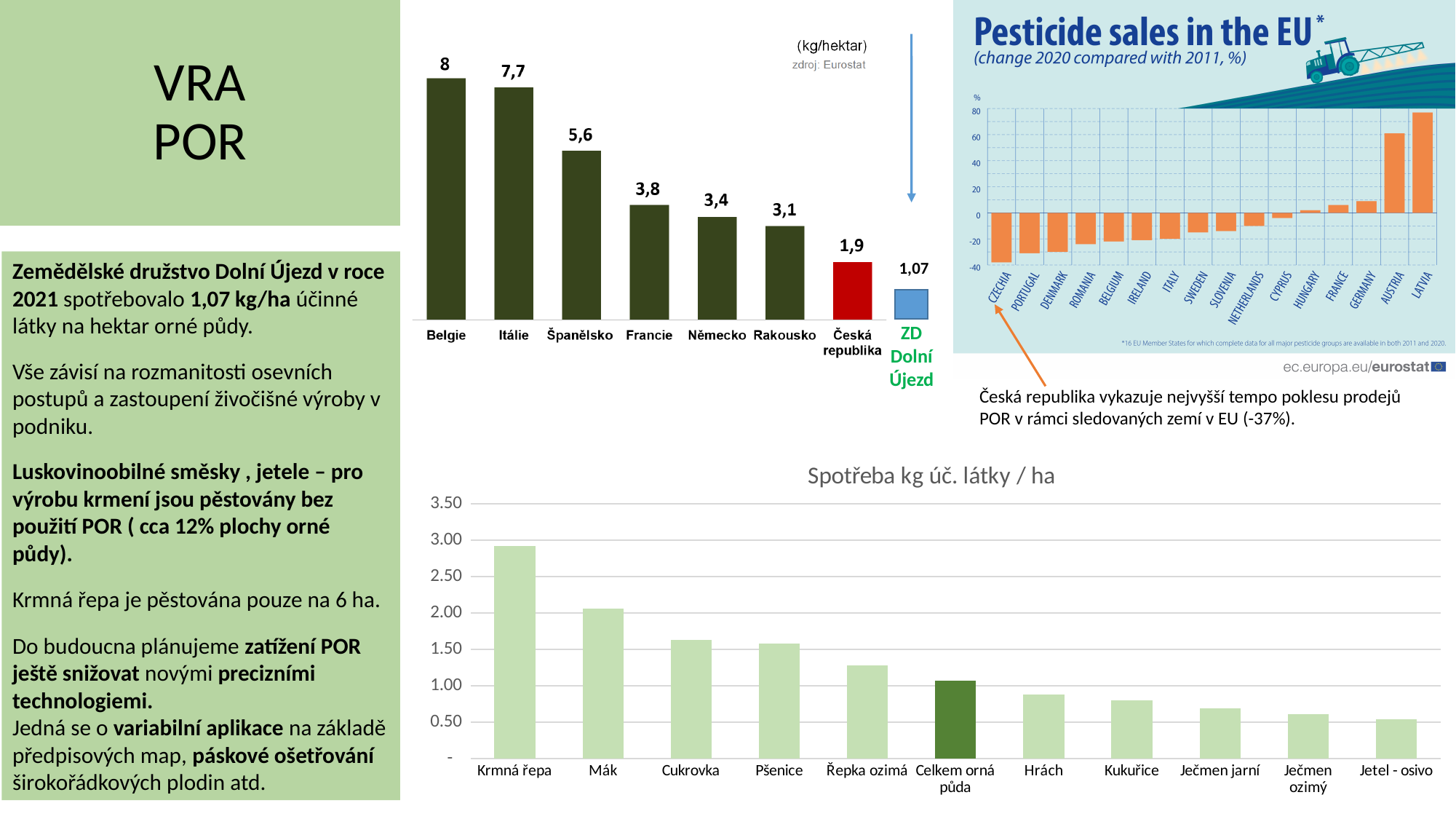
In the 'Pesticide sales in the EU' chart, which country has the highest value? Latvia In the top-middle bar chart (kg/hektar), what is the value for Česká republika? 1,9 In the top-middle bar chart (kg/hektar), which category has the highest value? Belgie In the top-middle bar chart (kg/hektar), what is the difference between the values for Itálie and Španělsko? 2,1 In the top-middle bar chart (kg/hektar), what is the value for Belgie? 8 In the 'Pesticide sales in the EU' chart, which country has the lowest value? Czechia In the 'Spotřeba kg úč. látky / ha' chart, is the value for Hrách greater or less than 1.00? less In the top-middle bar chart (kg/hektar), which is larger, the value for Francie or the value for Rakousko? Francie In the top-middle bar chart (kg/hektar), what is the value for ZD Dolní Újezd? 1,07 How many categories are shown in the top-middle bar chart (kg/hektar)? 8 In the 'Pesticide sales in the EU' chart, is the value for Austria greater or less than 40? greater In the 'Spotřeba kg úč. látky / ha' chart, which category has the highest value? Krmná řepa